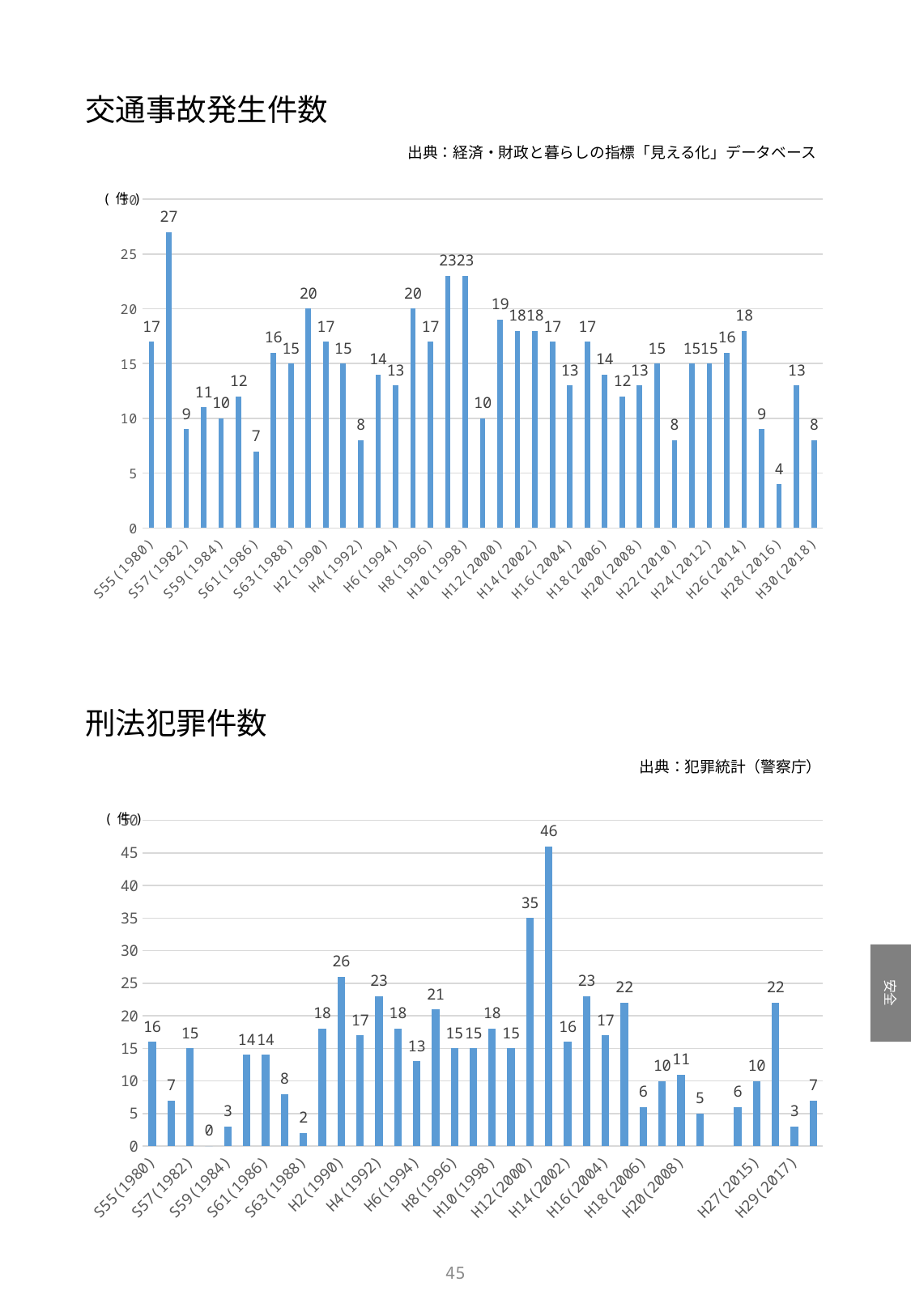
In the 交通事故発生件数 chart, what is the lowest value shown? 4 What is the source given for the 刑法犯罪件数 chart? 犯罪統計（警察庁） In the 交通事故発生件数 chart, what is the value for H28(2016)? 4 In the 刑法犯罪件数 chart, what is the value for S55(1980)? 16 In the 交通事故発生件数 chart, what is the value for H30(2018)? 8 In the 交通事故発生件数 chart, what is the highest value shown? 27 In the 交通事故発生件数 chart, what is the difference between the value for S55(1980) and the value for H30(2018)? 9 What kind of chart is the 交通事故発生件数 chart at the top of the slide? bar chart In the 交通事故発生件数 chart, what is the value for S55(1980)? 17 In the 刑法犯罪件数 chart, is the highest bar greater or less than 40? greater In the 刑法犯罪件数 chart, what is the lowest value shown? 0 In the 刑法犯罪件数 chart, what is the highest value shown? 46